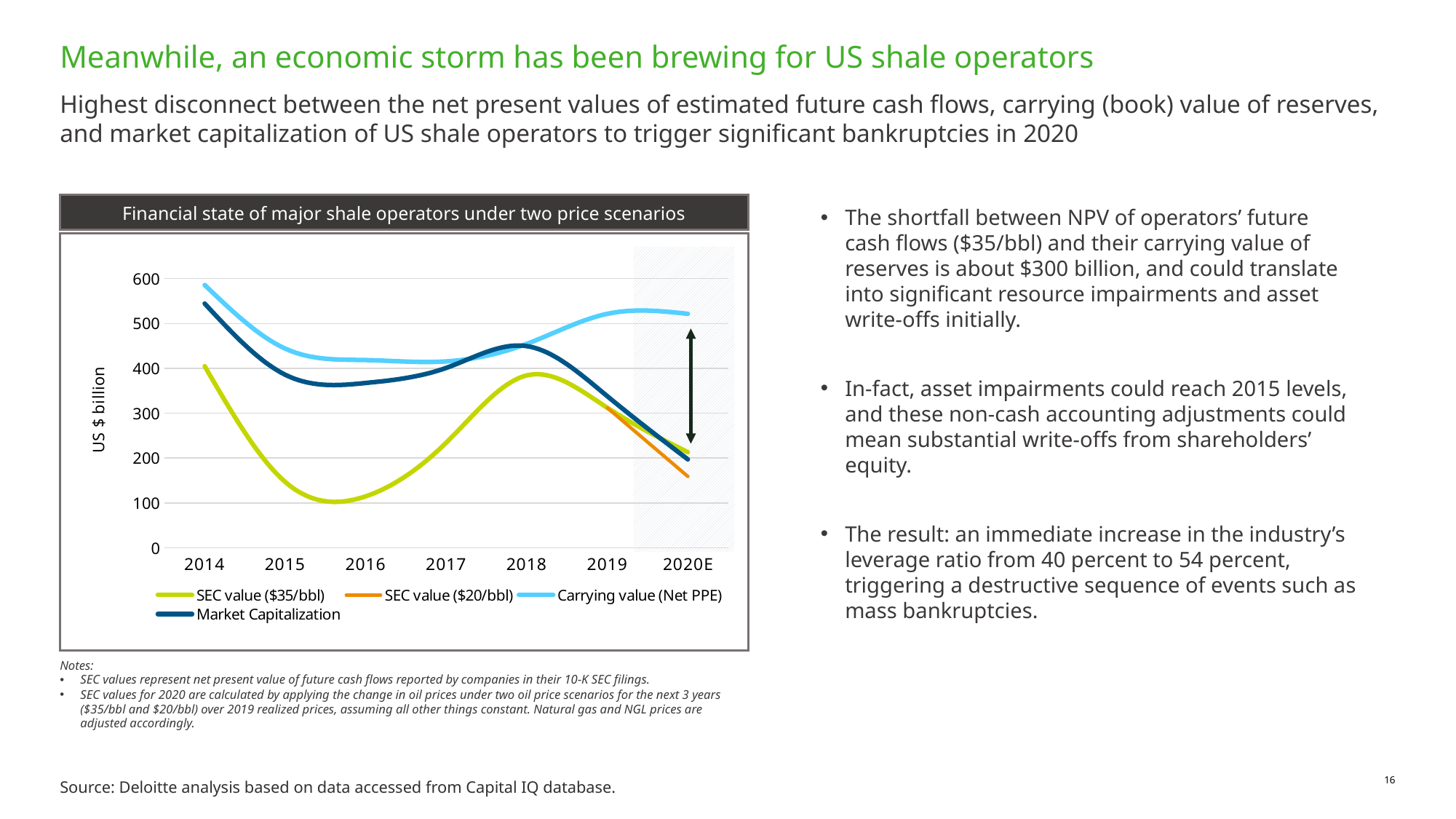
Is the SEC value ($35/bbl) in 2015 greater or less than 200? less Which series has the highest value in 2020E? Carrying value (Net PPE) In 2014, which is larger: the SEC value ($35/bbl) or the Carrying value (Net PPE)? Carrying value (Net PPE) How many years are shown on the x axis? 7 Does Market Capitalization rise or fall from 2018 to 2020E? fall How many series does the legend list? 4 What kind of chart is shown on the slide? Line chart Is the SEC value ($20/bbl) in 2020E greater or less than 200? less What is the label on the y axis? US $ billion Is the Market Capitalization in 2020E greater or less than 300? less What is the title of the chart? Financial state of major shale operators under two price scenarios